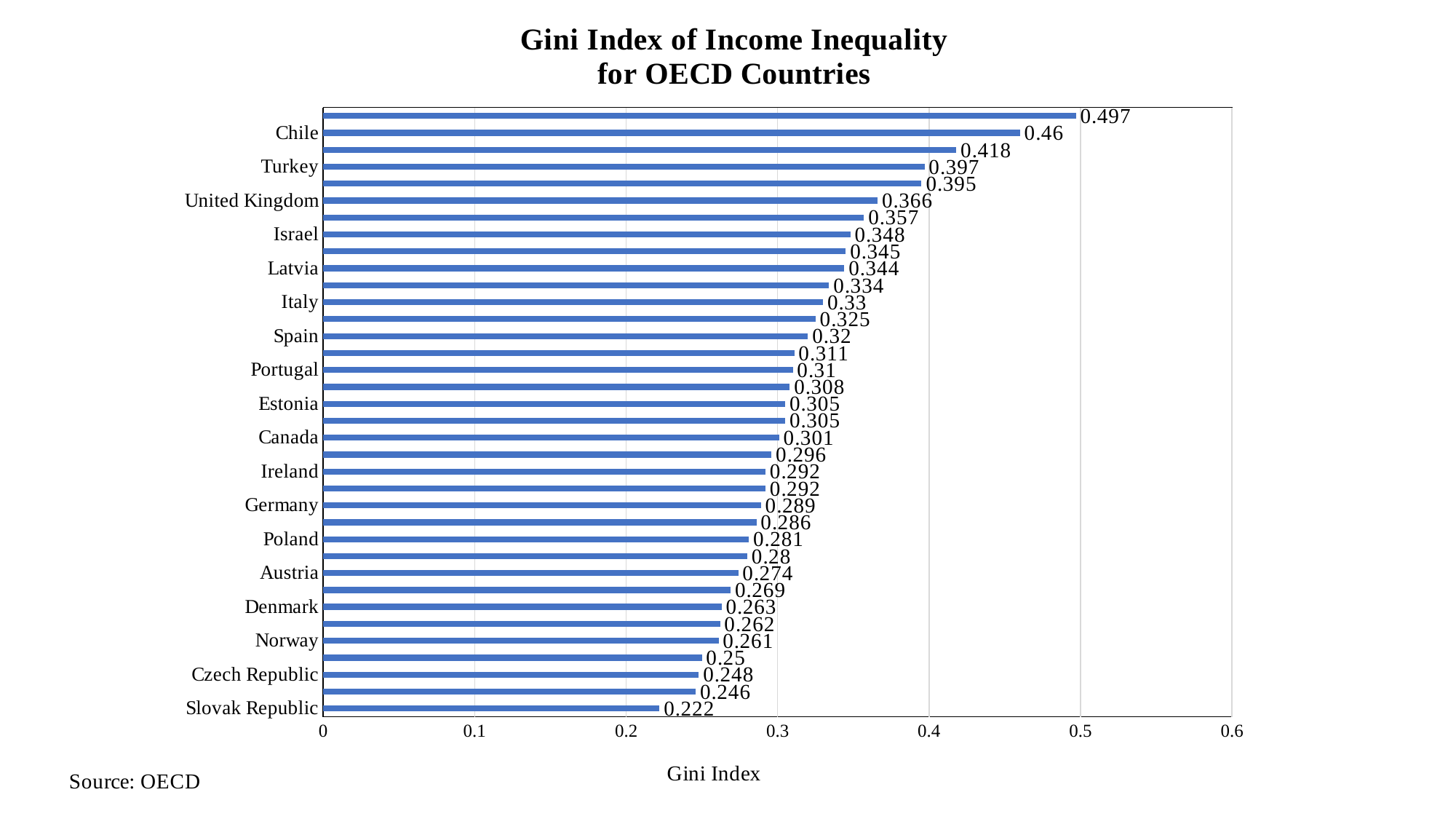
Do the Gini Index values increase or decrease going from the top bar to the bottom bar? Decrease What is the Gini Index value for the United Kingdom? 0.366 Which labeled country has the lowest Gini Index on the chart? Slovak Republic What is the Gini Index value for Chile? 0.46 What kind of chart is shown on the slide? Bar chart What is the Gini Index value for the Slovak Republic? 0.222 What is the Gini Index value for Germany? 0.289 What is the difference between the Gini Index values of Chile and the Slovak Republic? 0.238 Is the Gini Index value for Turkey greater or less than 0.3? greater Which has a higher Gini Index, Israel or Canada? Israel What is the label on the horizontal axis of the chart? Gini Index What is the highest Gini Index value shown on the chart? 0.497